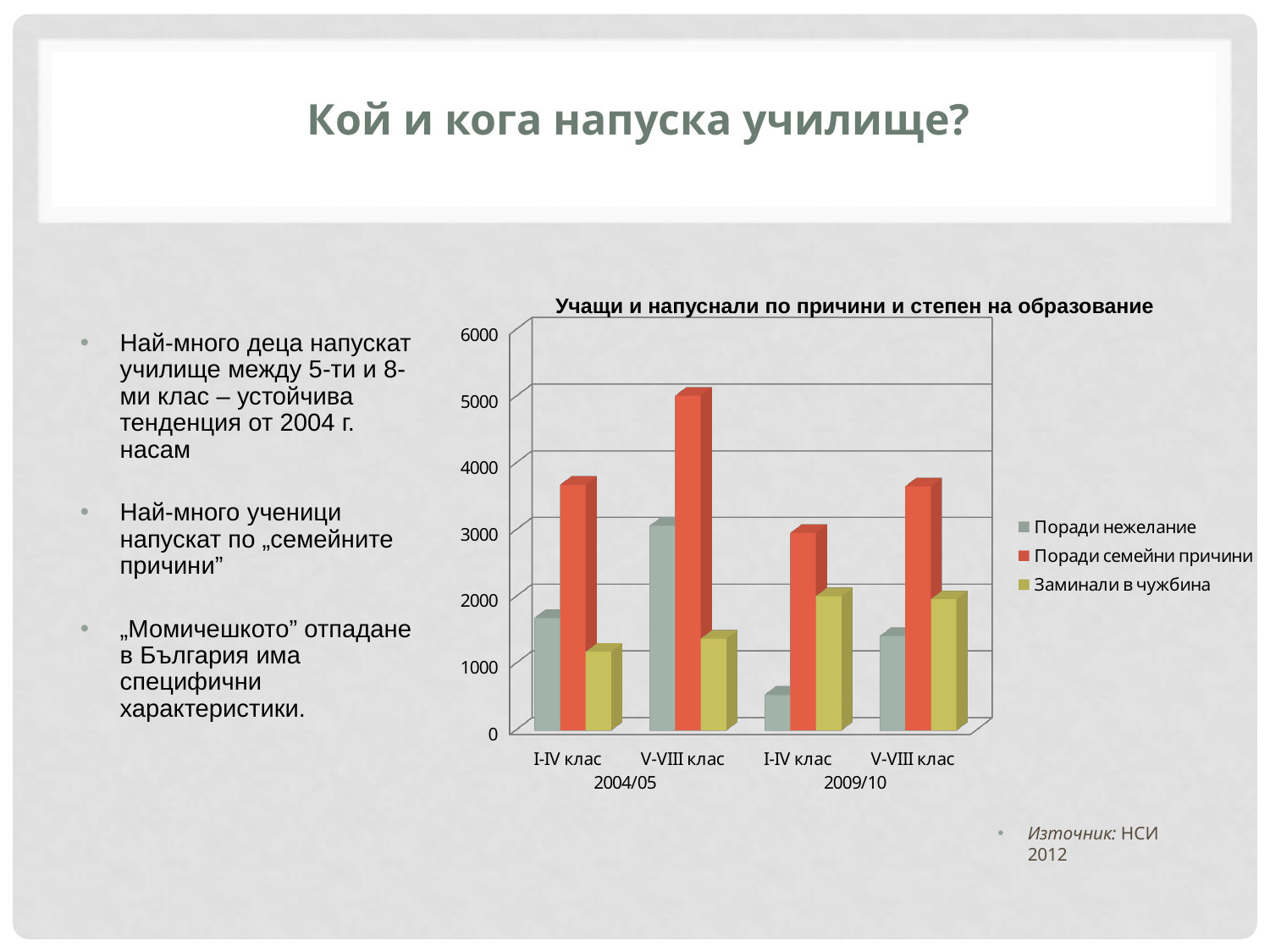
In V-VIII клас 2004/05, which is larger: 'Поради нежелание' or 'Заминали в чужбина'? Поради нежелание Is the value for 'Поради нежелание' in V-VIII клас 2004/05 greater or less than 2000? greater What is the title of the chart? Учащи и напуснали по причини и степен на образование How many category groups are shown along the x axis of the chart? 4 Which category has the highest bar for 'Поради семейни причини'? V-VIII клас 2004/05 In I-IV клас 2009/10, which is larger: 'Поради семейни причини' or 'Заминали в чужбина'? Поради семейни причини Which series is shown in red in the chart? Поради семейни причини Which category has the lowest bar for 'Поради нежелание'? I-IV клас 2009/10 Is the value for 'Поради семейни причини' in V-VIII клас 2004/05 greater or less than 4000? greater What type of chart is shown on the slide? Bar chart How many series does the chart legend list? 3 Is the value for 'Поради нежелание' in I-IV клас 2009/10 greater or less than 1000? less